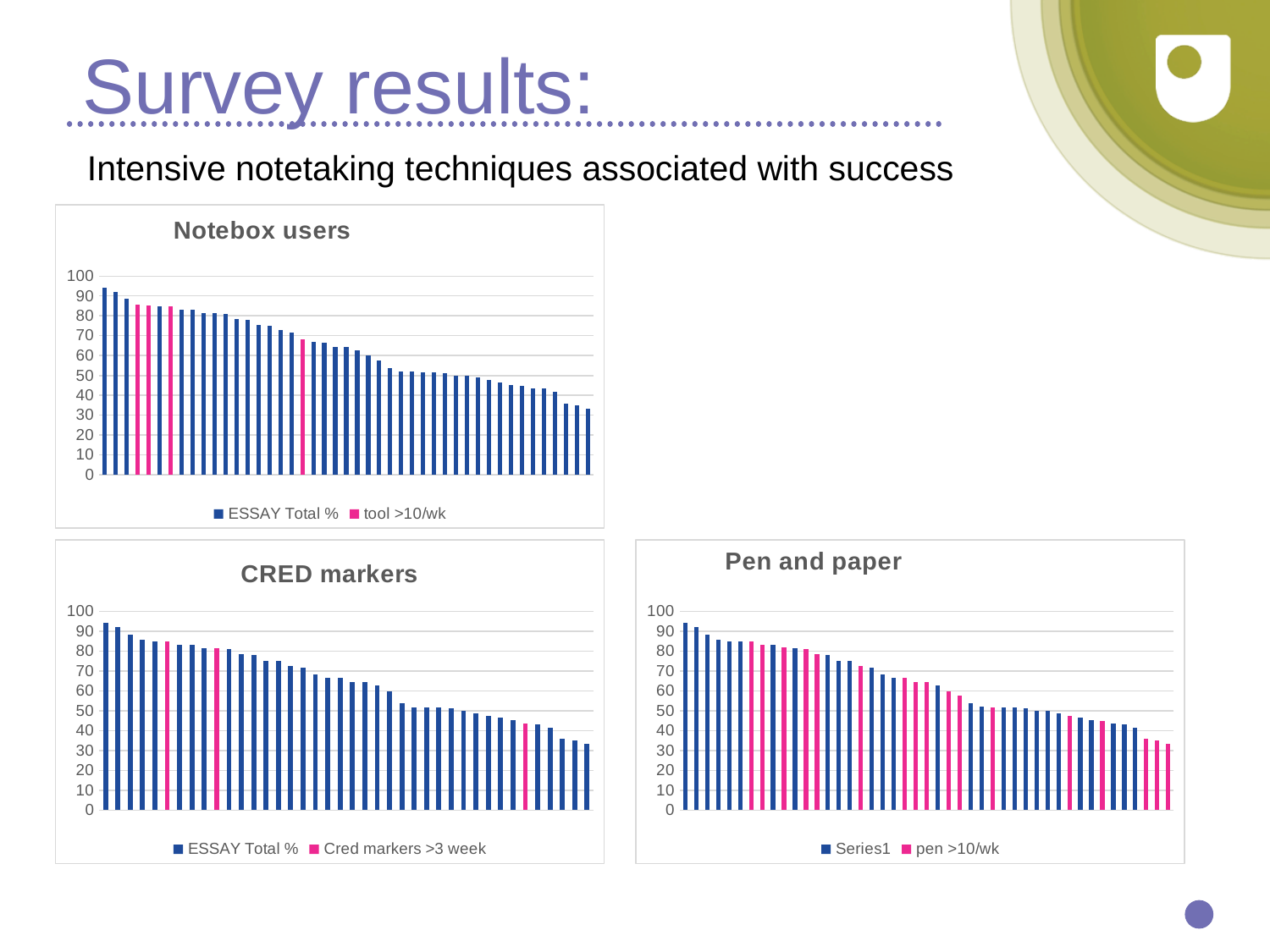
In the "Notebox users" chart, is the value of the leftmost bar greater or less than 90? greater In the "Pen and paper" chart, is the value of the rightmost bar greater or less than 40? less What kind of chart is the "Pen and paper" chart? bar chart In the "CRED markers" chart, is the value of the rightmost bar greater or less than 40? less In the "Pen and paper" chart, do the bar values rise or fall from left to right along the x axis? fall What kind of chart is the "Notebox users" chart? bar chart In the "Notebox users" chart, do the bar values rise or fall from left to right along the x axis? fall In the "CRED markers" chart, do the bar values rise or fall from left to right along the x axis? fall How many series does the legend of the "Pen and paper" chart list? 2 How many series does the legend of the "Notebox users" chart list? 2 How many series does the legend of the "CRED markers" chart list? 2 What is the name of the second (pink) series in the legend of the "CRED markers" chart? Cred markers >3 week